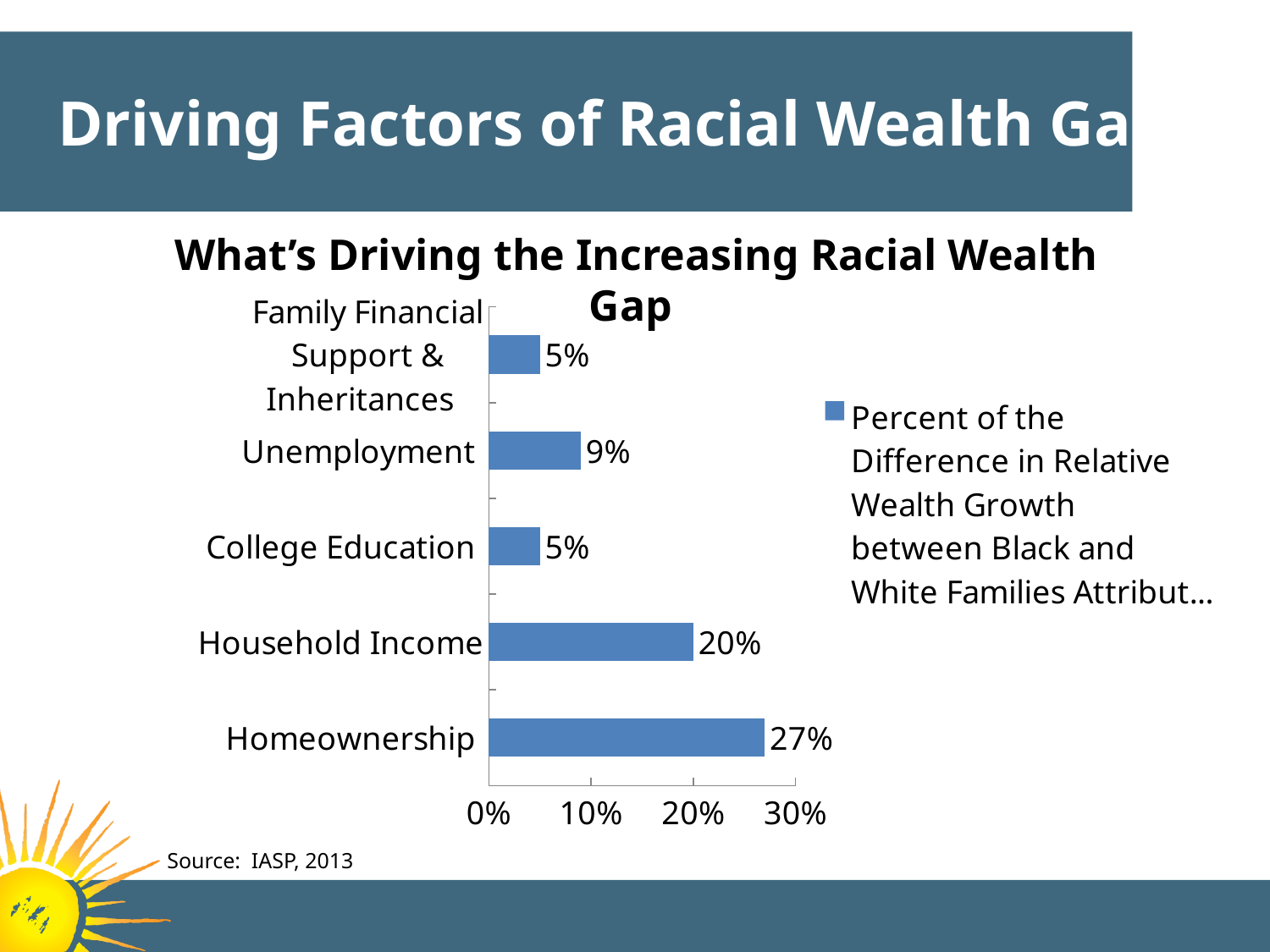
Which is larger, the value for Household Income or the value for Unemployment? Household Income What is the value for Unemployment? 9% Is the value for Homeownership greater or less than 20%? greater What is the source cited for the chart? IASP, 2013 What kind of chart is shown on the slide? Bar chart What is the value for College Education? 5% Which category has the highest value? Homeownership What is the difference between the values for Homeownership and Household Income? 7% How many categories are shown in the chart? 5 What is the value for Household Income? 20% What is the difference between the values for Unemployment and College Education? 4% What is the value for Homeownership? 27%